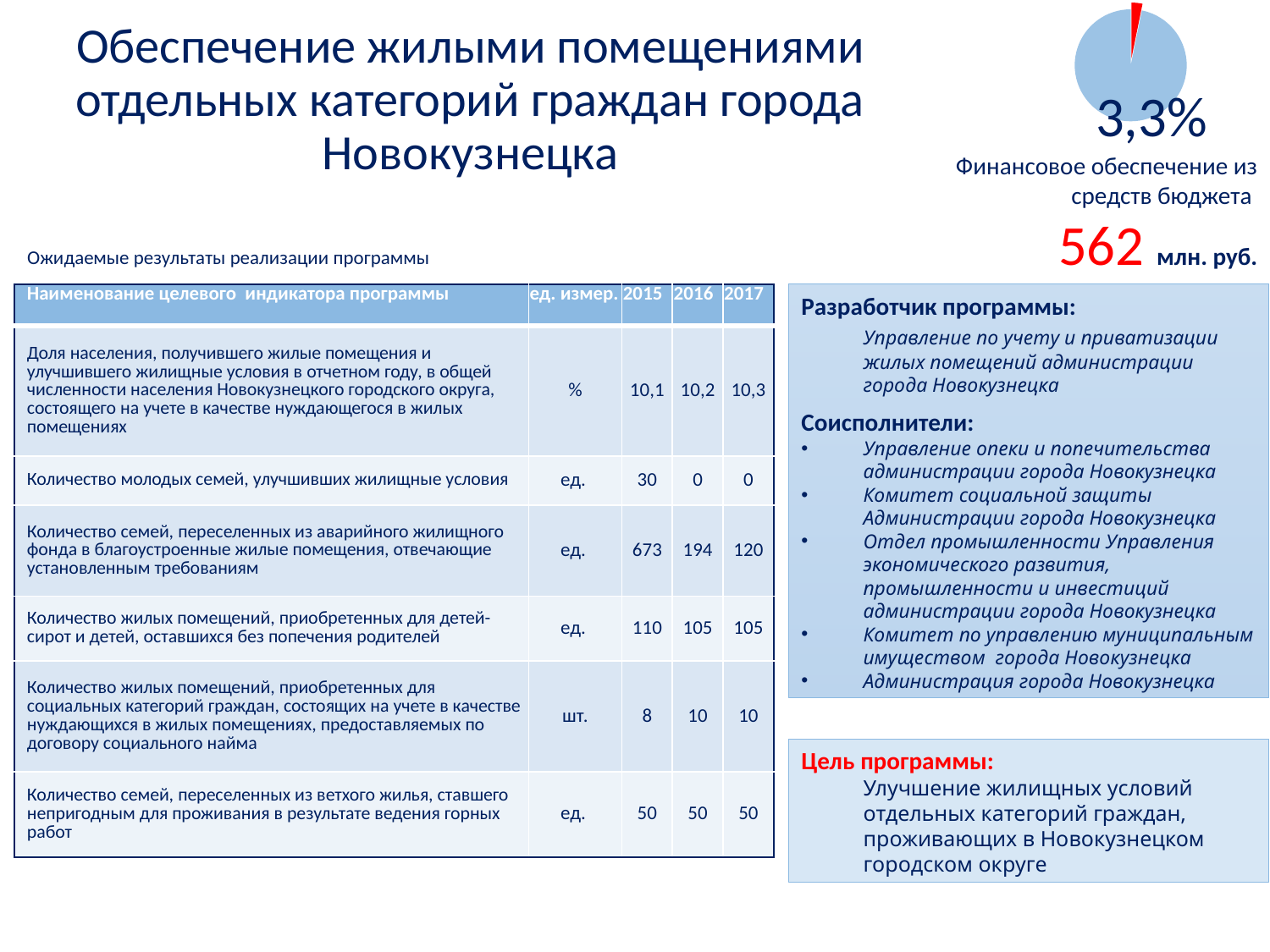
How many slices does the pie chart have? 2 What colour is the slice of the pie chart labelled 3,3%? red Which slice of the pie chart is the smallest? the red slice (3,3%) What kind of chart is shown in the top right corner of the slide? pie chart Which slice of the pie chart is larger, the red one or the light blue one? the light blue one What text appears directly below the pie chart? Финансовое обеспечение из средств бюджета What share is printed next to the small red slice of the pie chart? 3,3%